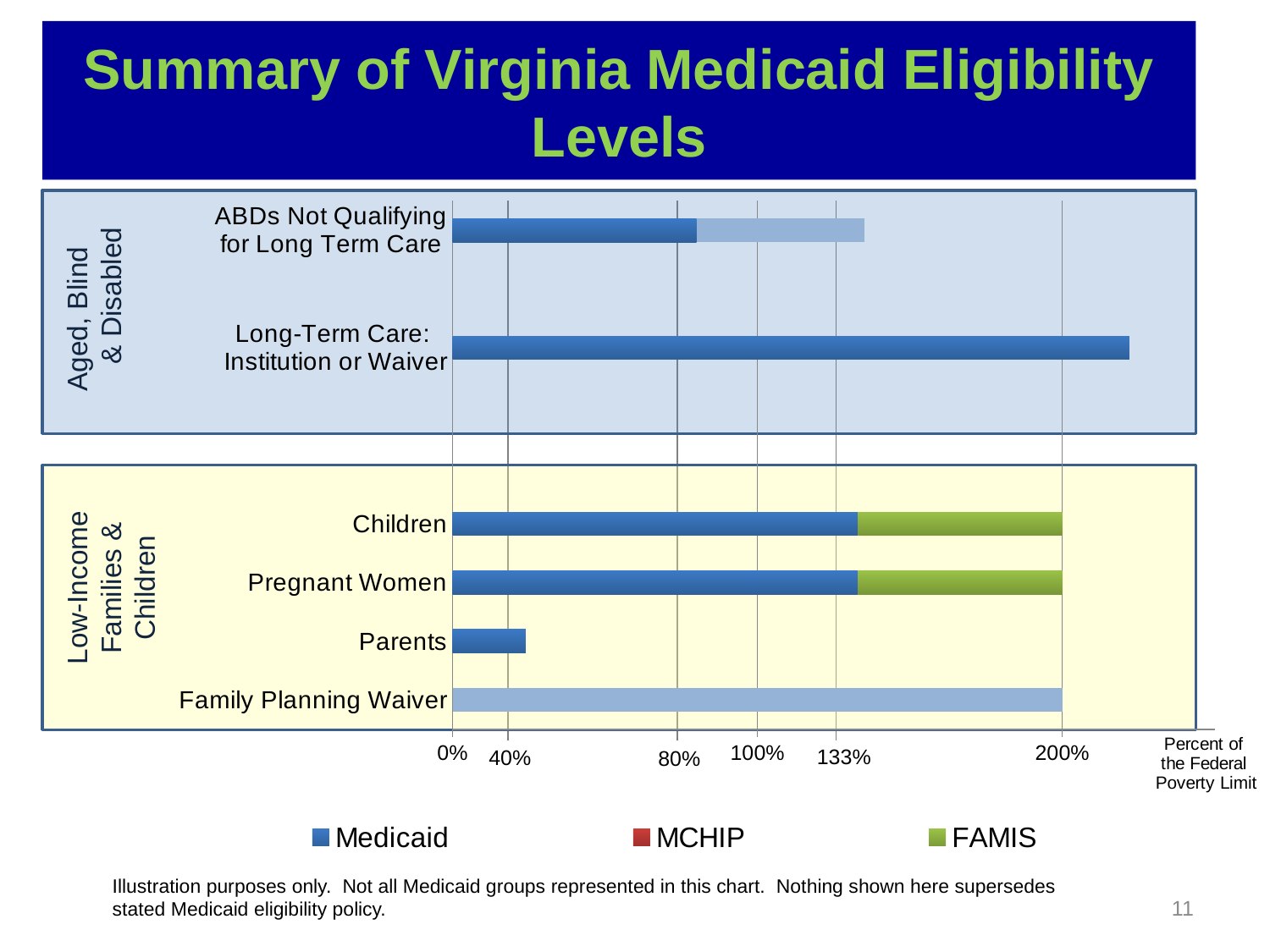
Which category has the shortest bar in the chart? Parents Is the value for Parents greater or less than 80%? less How many series does the chart legend list? 3 Is the total bar for ABDs Not Qualifying for Long Term Care greater or less than 100%? greater Is the value for Long-Term Care: Institution or Waiver greater or less than 200%? greater At what percent of the Federal Poverty Limit does the Family Planning Waiver bar end? 200% What are the three series named in the chart legend? Medicaid, MCHIP, FAMIS What kind of chart is shown on the slide? Bar chart Which category has the longest bar in the chart? Long-Term Care: Institution or Waiver How many categories are plotted in the chart? 6 What does the horizontal axis of the chart measure? Percent of the Federal Poverty Limit Which is larger, the bar for Children or the bar for Parents? Children